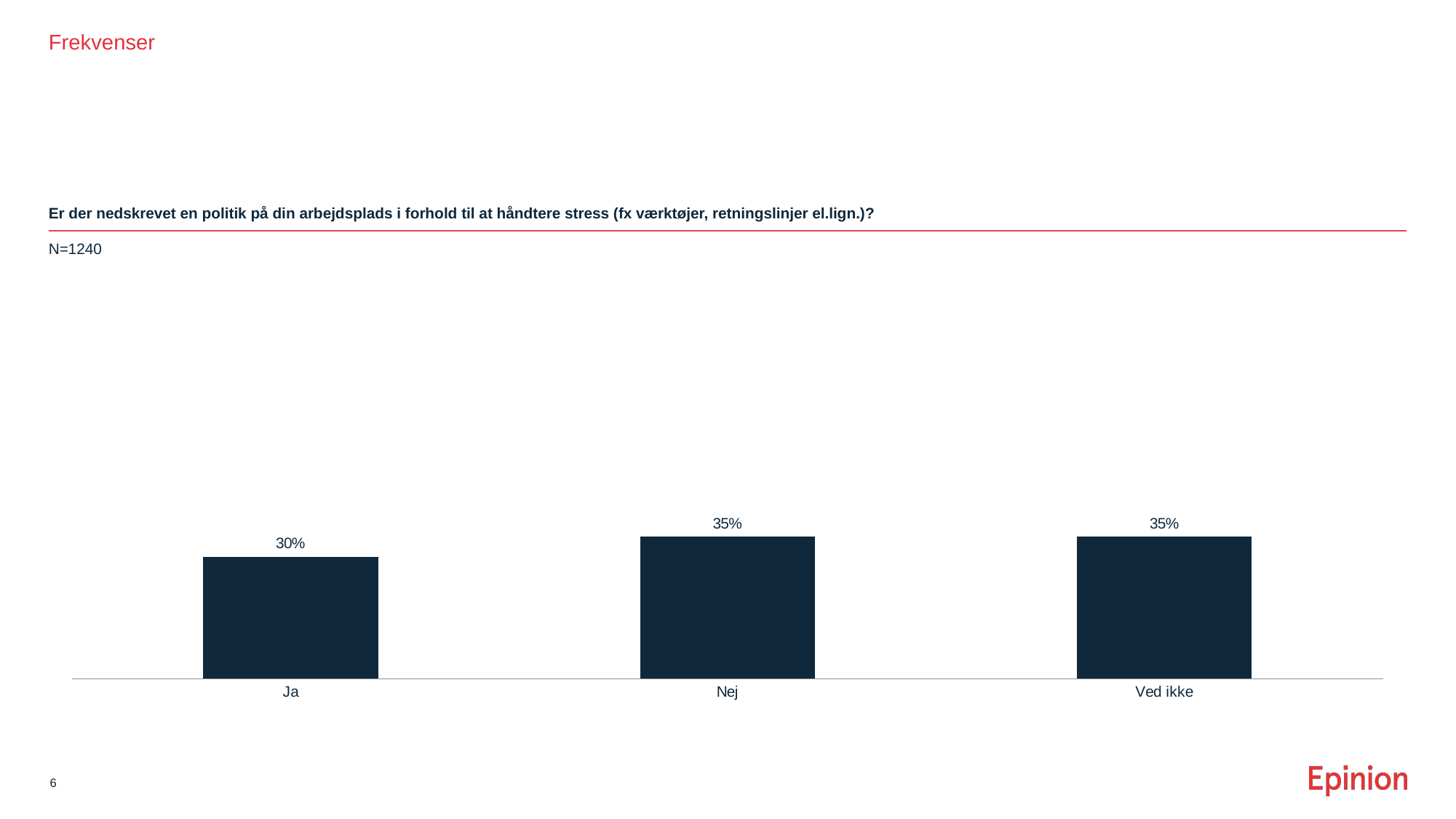
What is the label of the rightmost category on the x axis? Ved ikke Which category has the lowest value? Ja What is the sample size (N) stated for the chart? N=1240 How many categories are shown in the chart? 3 What is the value for "Ja"? 30% Which is larger, the value for "Ja" or the value for "Ved ikke"? Ved ikke What is the value for "Ved ikke"? 35% What is the difference between the values for "Nej" and "Ja"? 5% What is the value for "Nej"? 35% What kind of chart is shown on the slide? Bar chart